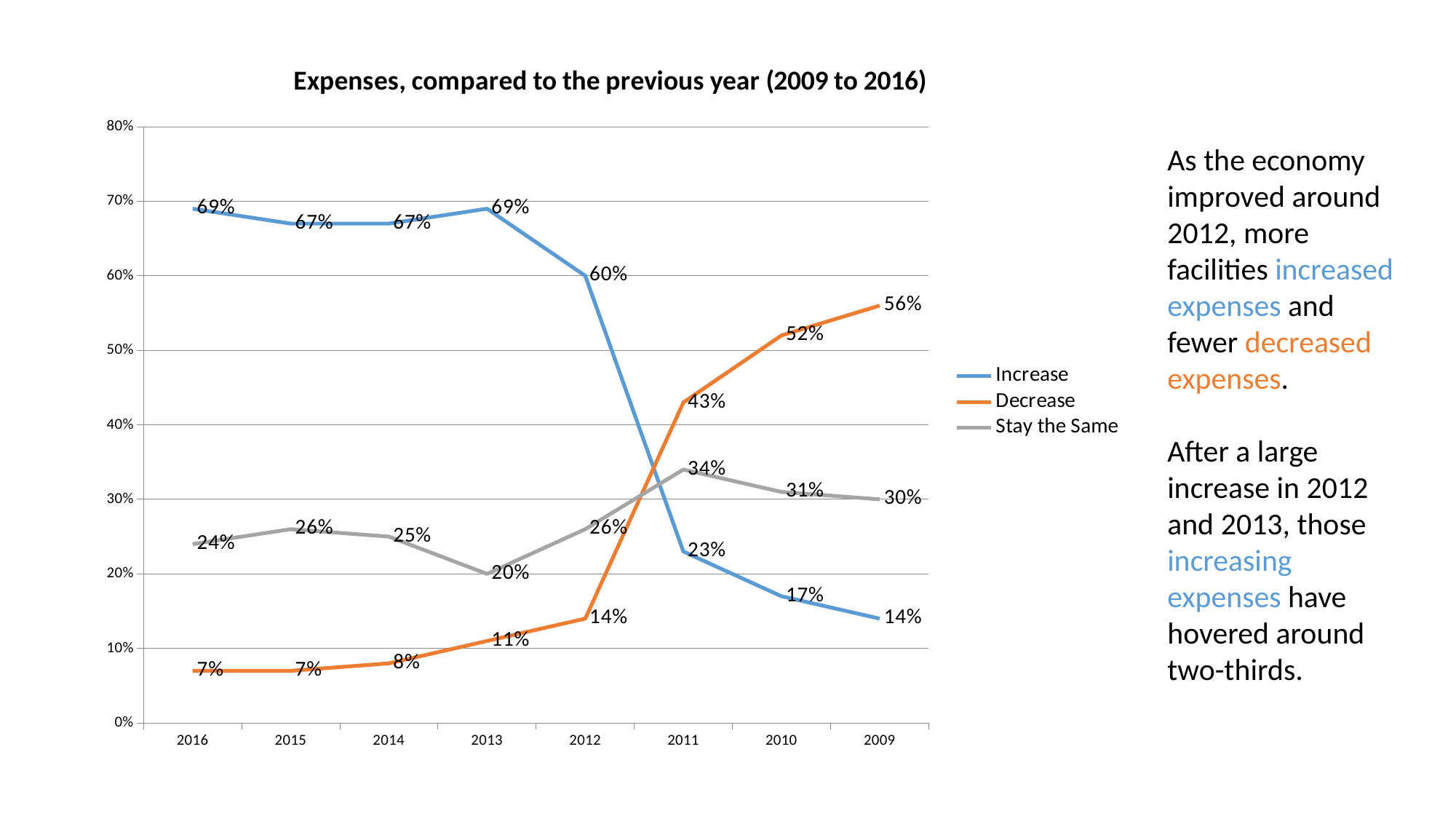
How many series does the legend list? 3 Does the Decrease series rise or fall from 2016 to 2009 along the x axis? Rise What is the value for Increase in 2012? 60% In which year is the Stay the Same series at its highest? 2011 What is the title of the chart? Expenses, compared to the previous year (2009 to 2016) What is the value for Stay the Same in 2013? 20% Which is larger in 2011, the Increase value or the Decrease value? Decrease How many years are shown on the x axis? 8 What is the value for Decrease in 2009? 56% In which year is the Decrease series at its lowest? 2016 and 2015 (7%) What is the difference between the Increase value in 2013 and the Increase value in 2012? 9% What kind of chart is shown on the slide? Line chart